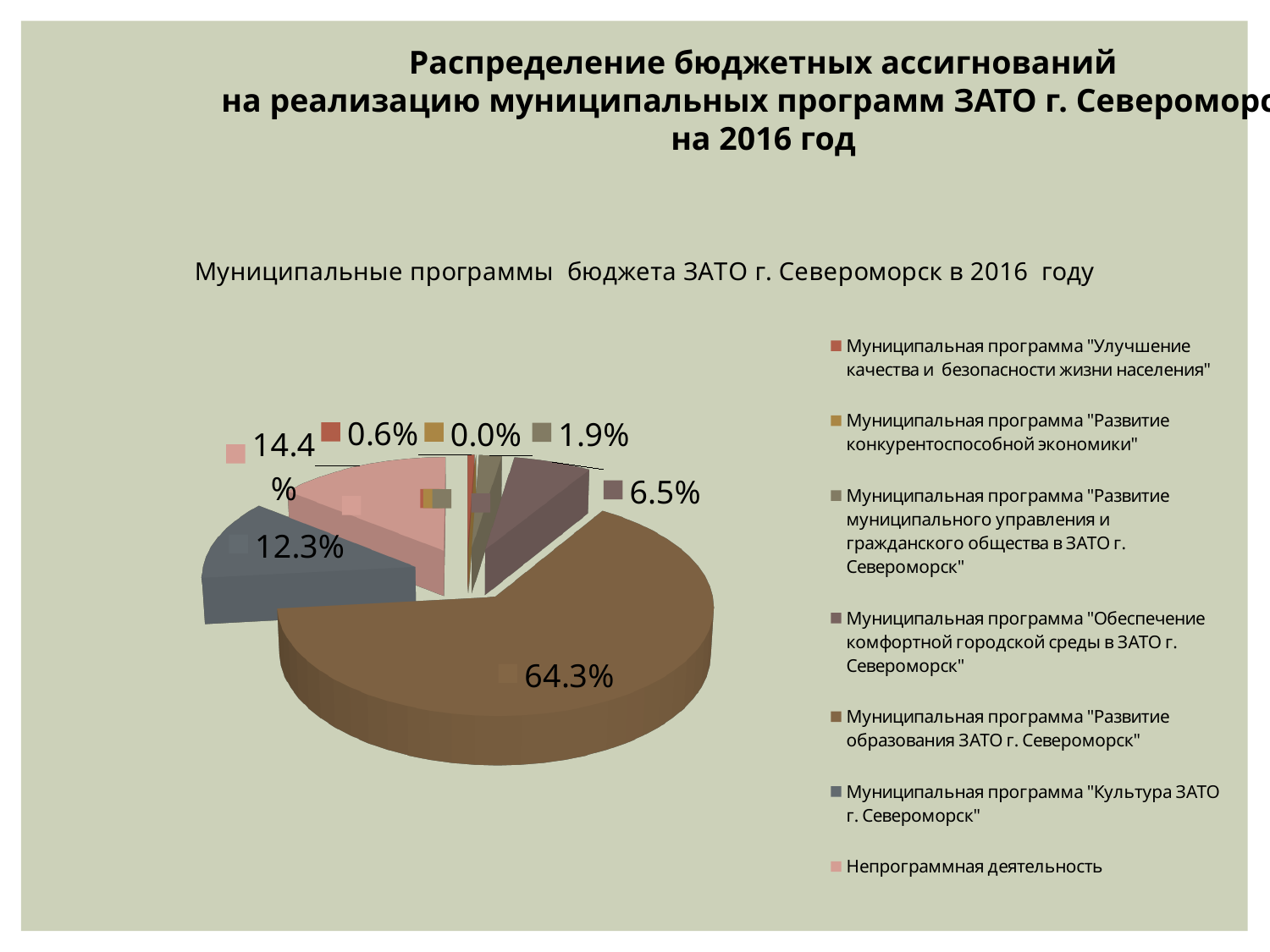
What share of the pie does the slice for Муниципальная программа "Развитие образования ЗАТО г. Североморск" have? 64.3% Which is larger: the share for Муниципальная программа "Обеспечение комфортной городской среды в ЗАТО г. Североморск" or for Муниципальная программа "Развитие муниципального управления и гражданского общества в ЗАТО г. Североморск"? Муниципальная программа "Обеспечение комфортной городской среды в ЗАТО г. Североморск" Which category has the largest slice of the pie? Муниципальная программа "Развитие образования ЗАТО г. Североморск" What share is shown for Муниципальная программа "Развитие конкурентоспособной экономики"? 0.0% What share is shown for Непрограммная деятельность? 14.4% Which category has the smallest slice of the pie? Муниципальная программа "Развитие конкурентоспособной экономики" What is the title of the pie chart? Муниципальные программы бюджета ЗАТО г. Североморск в 2016 году What share is shown for Муниципальная программа "Обеспечение комфортной городской среды в ЗАТО г. Североморск"? 6.5% What share is shown for Муниципальная программа "Культура ЗАТО г. Североморск"? 12.3% How many categories does the legend of the pie chart list? 7 What kind of chart is shown on the slide? Pie chart What is the difference between the shares for Непрограммная деятельность and Муниципальная программа "Культура ЗАТО г. Североморск"? 2.1%